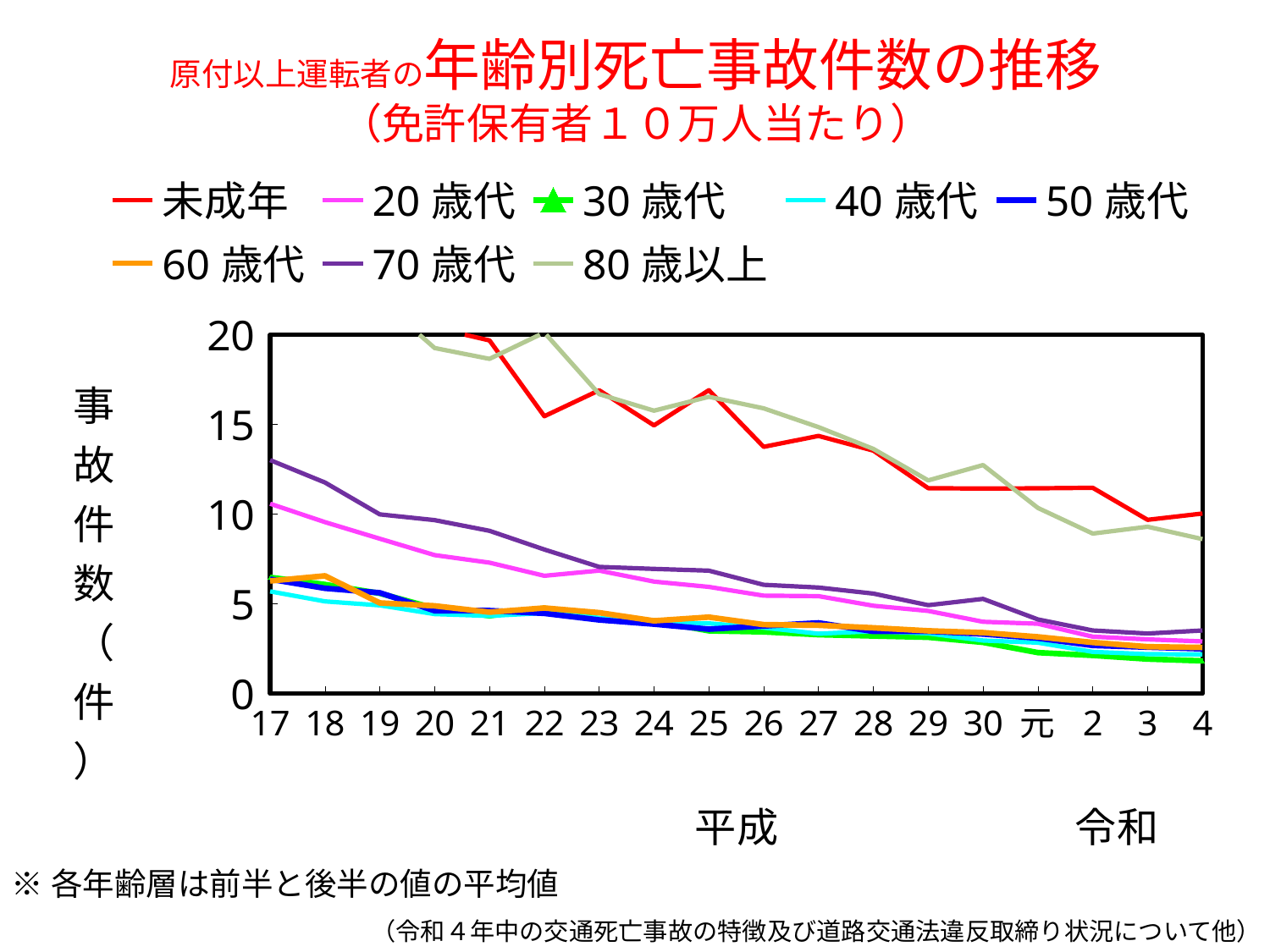
Is the value for 80歳以上 at 令和4 greater or less than 10? less Is the value for 未成年 at 平成25 greater or less than 15? greater Is the value for 70歳代 at 平成17 greater or less than 10? greater How many series does the legend list? 8 What is the label of the y axis? 事故件数（件） Does the value for 70歳代 rise or fall across the x axis overall? fall What kind of chart is shown on the slide? line chart At 令和4, which is larger, the value for 未成年 or the value for 80歳以上? 未成年 Does the value for 未成年 rise or fall from 平成22 to 令和4 overall? fall At 平成17, which is larger, the value for 70歳代 or the value for 20歳代? 70歳代 How many points are marked along the x axis? 18